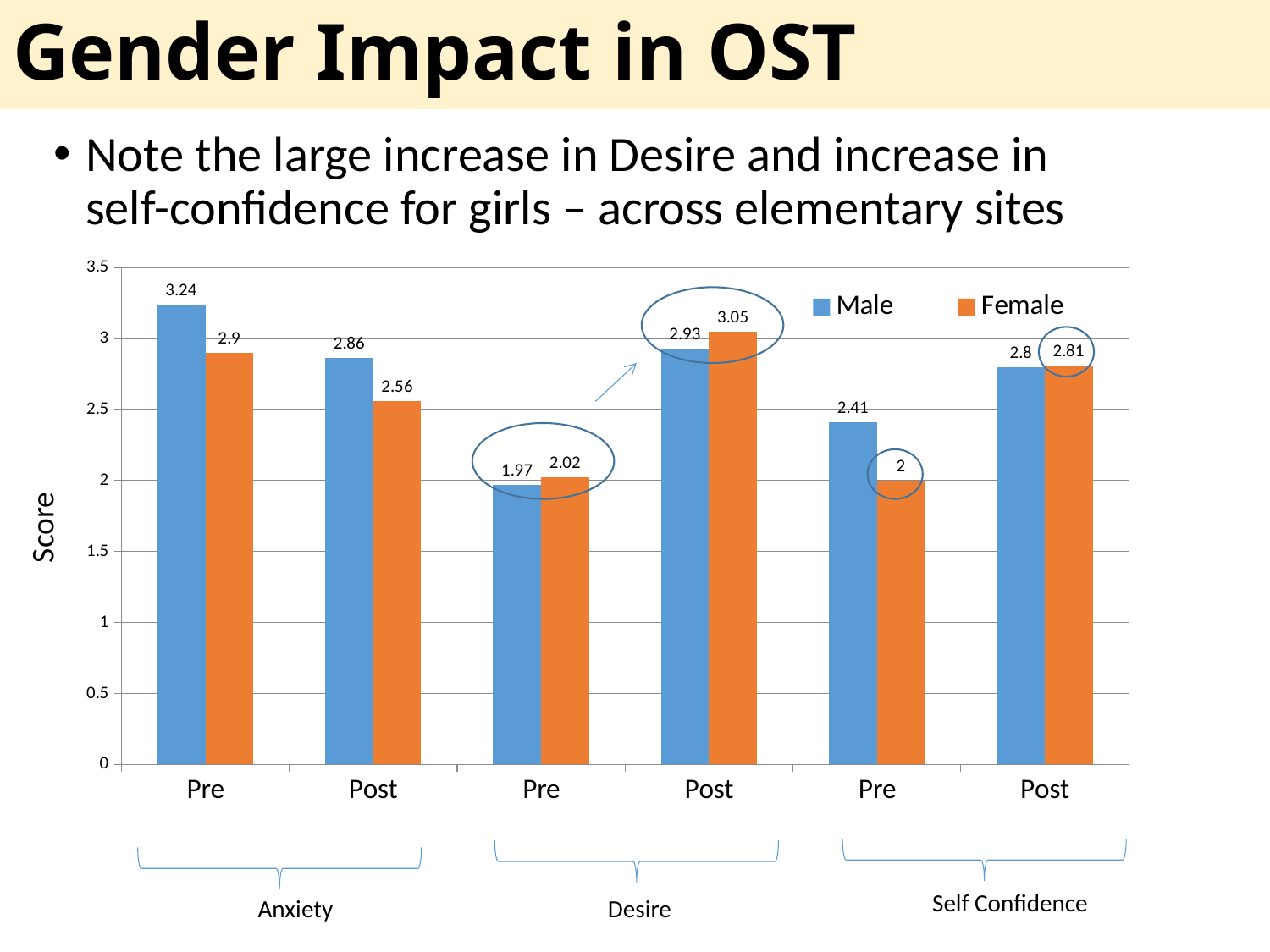
How many series does the legend list? 2 Which category has the highest Male score? Anxiety Pre Which is larger for Self Confidence Pre, the Male score or the Female score? Male What is the difference between the Female Desire Post score and the Female Desire Pre score? 1.03 What is the Female score for Self Confidence Pre? 2 What kind of chart is shown on the slide? Bar chart Is the Male score for Anxiety Post greater or less than 3? less What is the Female score for Desire Post? 3.05 Which category has the lowest Female score? Self Confidence Pre What is the Male score for Anxiety Pre? 3.24 What is the label of the vertical axis? Score What is the Male score for Desire Pre? 1.97